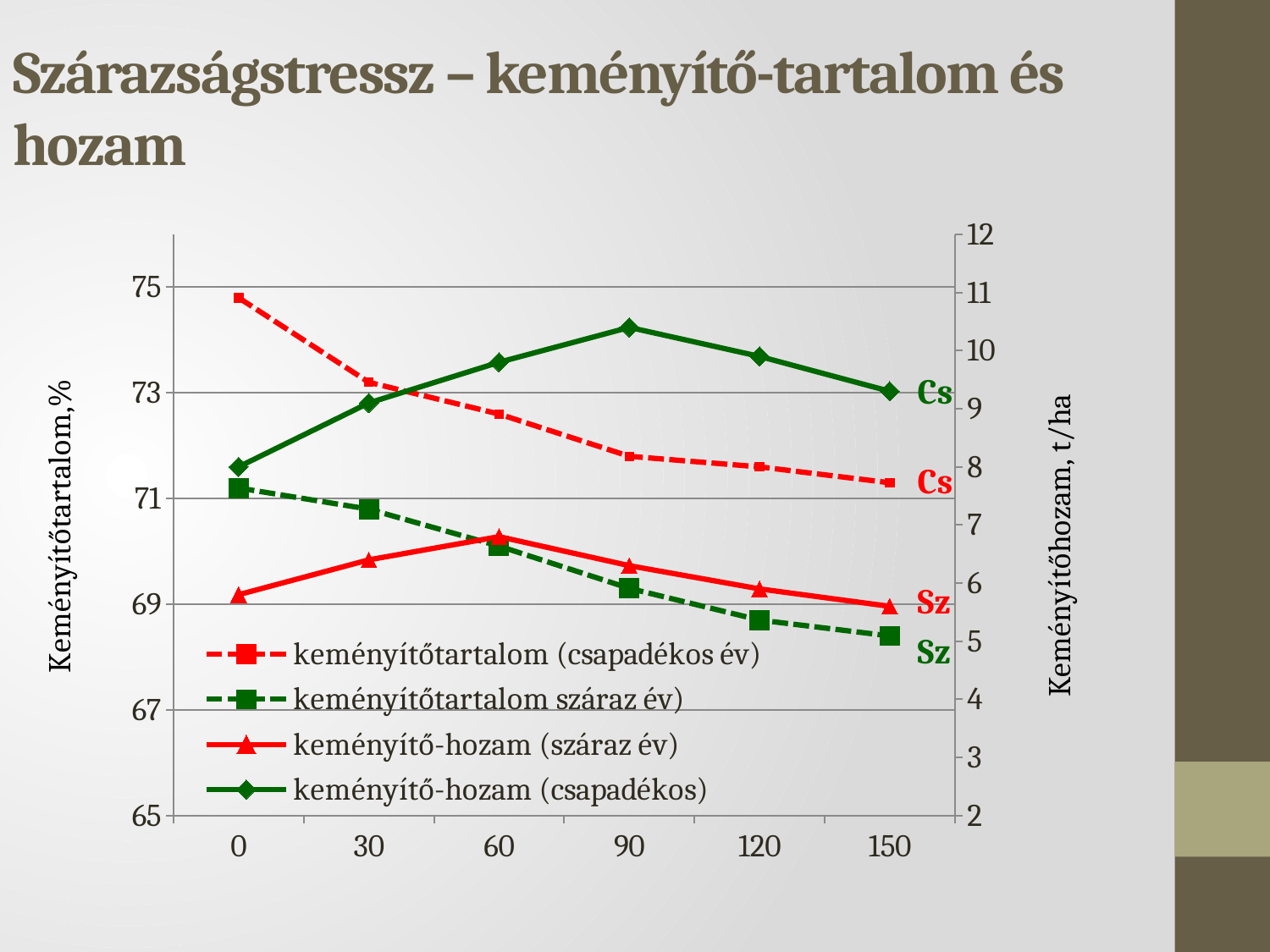
Is the value for keményítőtartalom (csapadékos év) at x = 0 greater or less than 73? greater Is the value for keményítőtartalom száraz év at x = 150 greater or less than 69? less How many points along the x axis are plotted for each series? 6 At x = 0, which series has the higher starch content: keményítőtartalom (csapadékos év) or keményítőtartalom száraz év? keményítőtartalom (csapadékos év) What kind of chart is shown on the slide? line chart At which x-axis value does the keményítő-hozam (száraz év) series reach its highest point? 60 Does the keményítőtartalom (csapadékos év) series rise or fall from 0 to 150 along the x axis? fall Does the keményítőtartalom száraz év series rise or fall from 0 to 150 along the x axis? fall What is the title of the right-hand vertical axis? Keményítőhozam, t/ha At which x-axis value is the keményítőtartalom (csapadékos év) series lowest? 150 At which x-axis value does the keményítő-hozam (csapadékos) series reach its highest point? 90 How many series does the legend list? 4